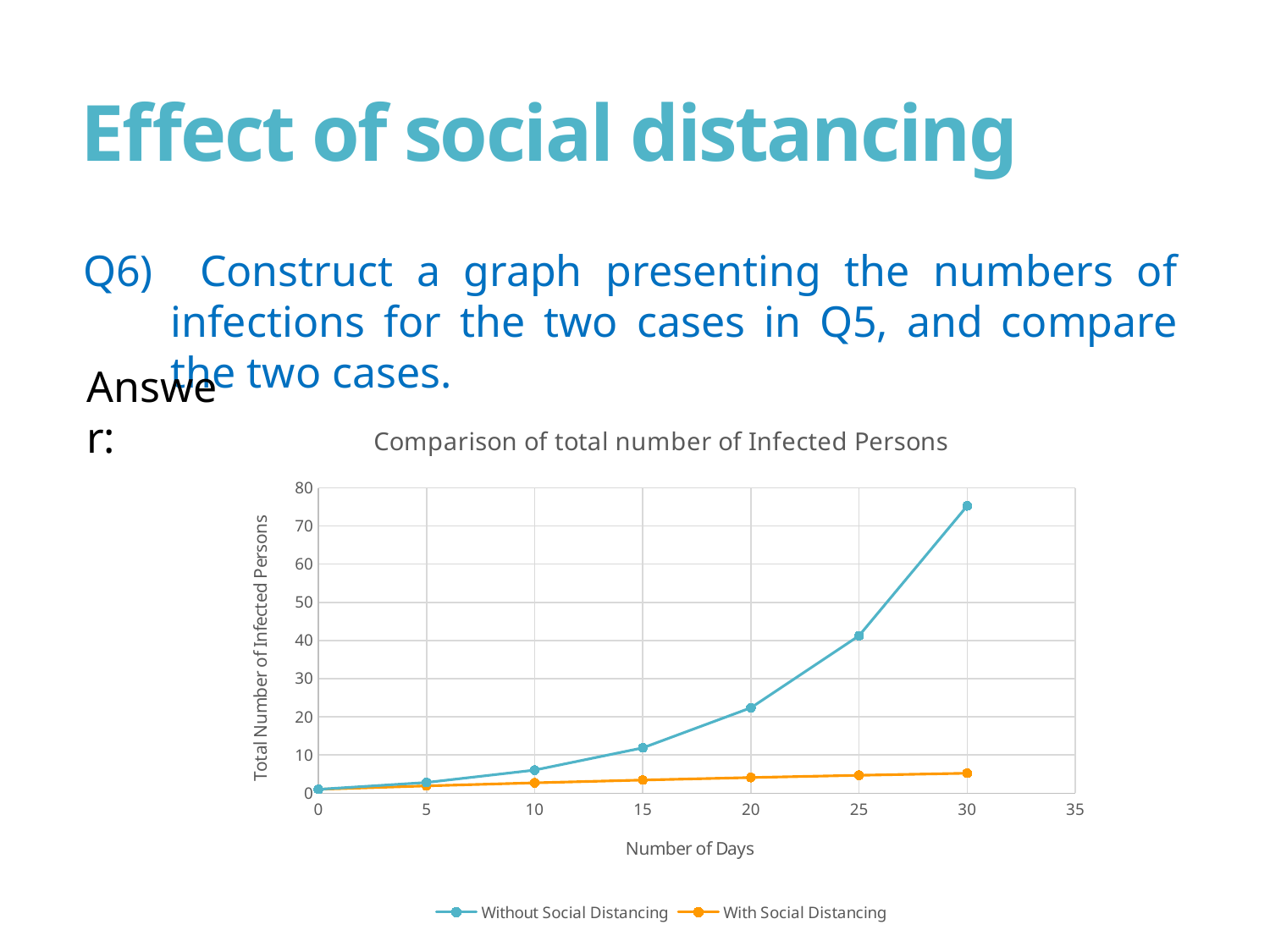
What is the title of the chart? Comparison of total number of Infected Persons At which day does the Without Social Distancing series reach its highest value? 30 How many data points are plotted for the Without Social Distancing series? 7 How many series does the legend list? 2 What kind of chart is shown on the slide? line chart Is the value for With Social Distancing at day 30 greater or less than 10? less Is the value for Without Social Distancing at day 25 greater or less than 30? greater Is the value for Without Social Distancing at day 30 greater or less than 70? greater Do the values for Without Social Distancing rise or fall as the number of days increases? rise What is the label of the x axis? Number of Days Which series has the larger value at day 30, Without Social Distancing or With Social Distancing? Without Social Distancing